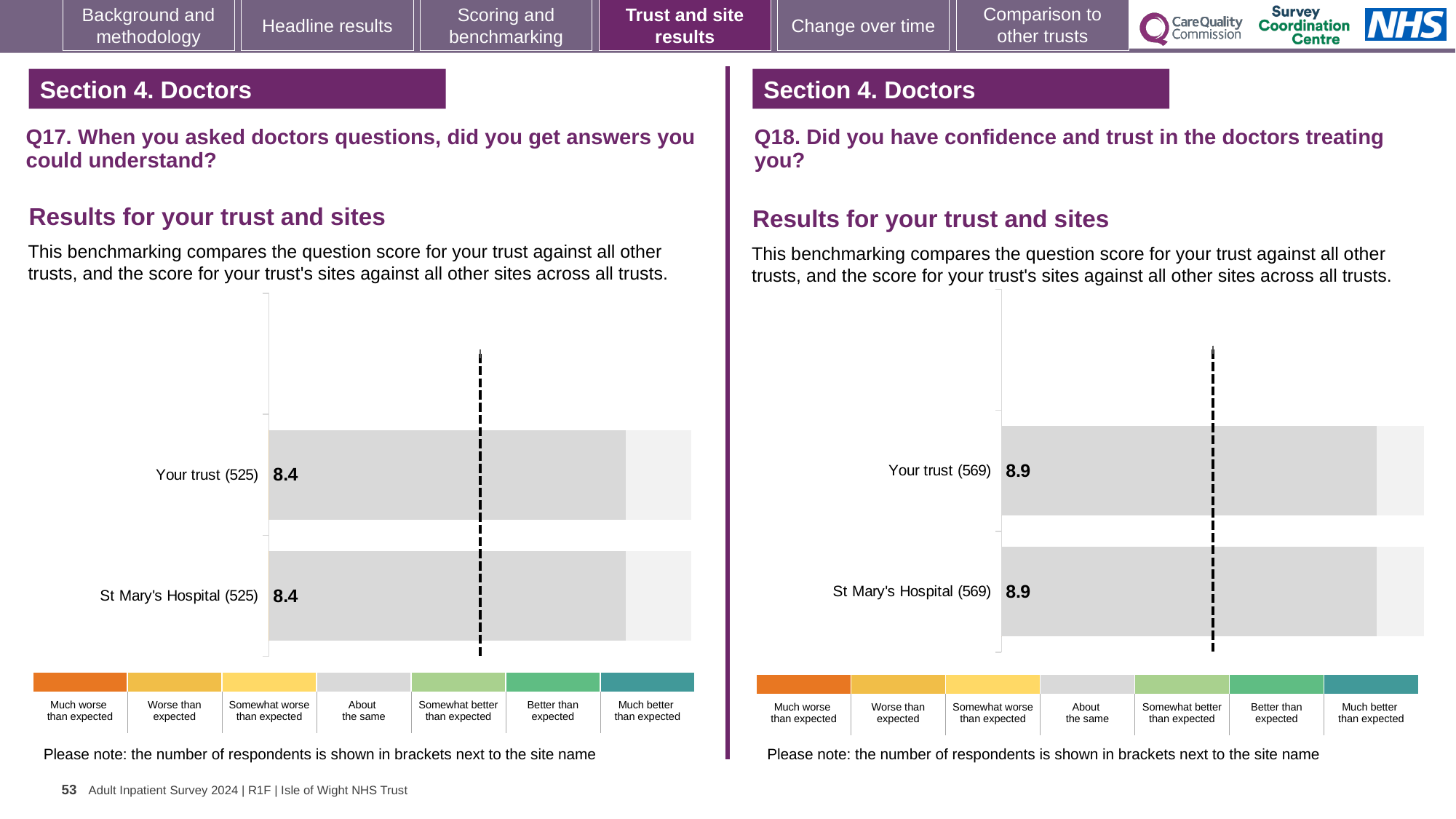
On the Q18 chart (right), what is the score for Your trust? 8.9 What kind of chart is used on the Q18 chart (right)? Bar chart On the Q17 chart (left), what is the difference between the scores for Your trust and St Mary's Hospital? 0 On the Q18 chart (right), how many respondents are shown in brackets for St Mary's Hospital? 569 On the Q17 chart (left), how many respondents are shown in brackets for Your trust? 525 How many bars are plotted on the Q17 chart (left)? 2 On the Q17 chart (left), what is the score for St Mary's Hospital? 8.4 How many categories does the colour key below the Q17 chart (left) list? 7 How many bars are plotted on the Q18 chart (right)? 2 On the Q17 chart (left), what is the score for Your trust? 8.4 On the Q18 chart (right), what is the difference between the scores for Your trust and St Mary's Hospital? 0 On the Q18 chart (right), what is the score for St Mary's Hospital? 8.9